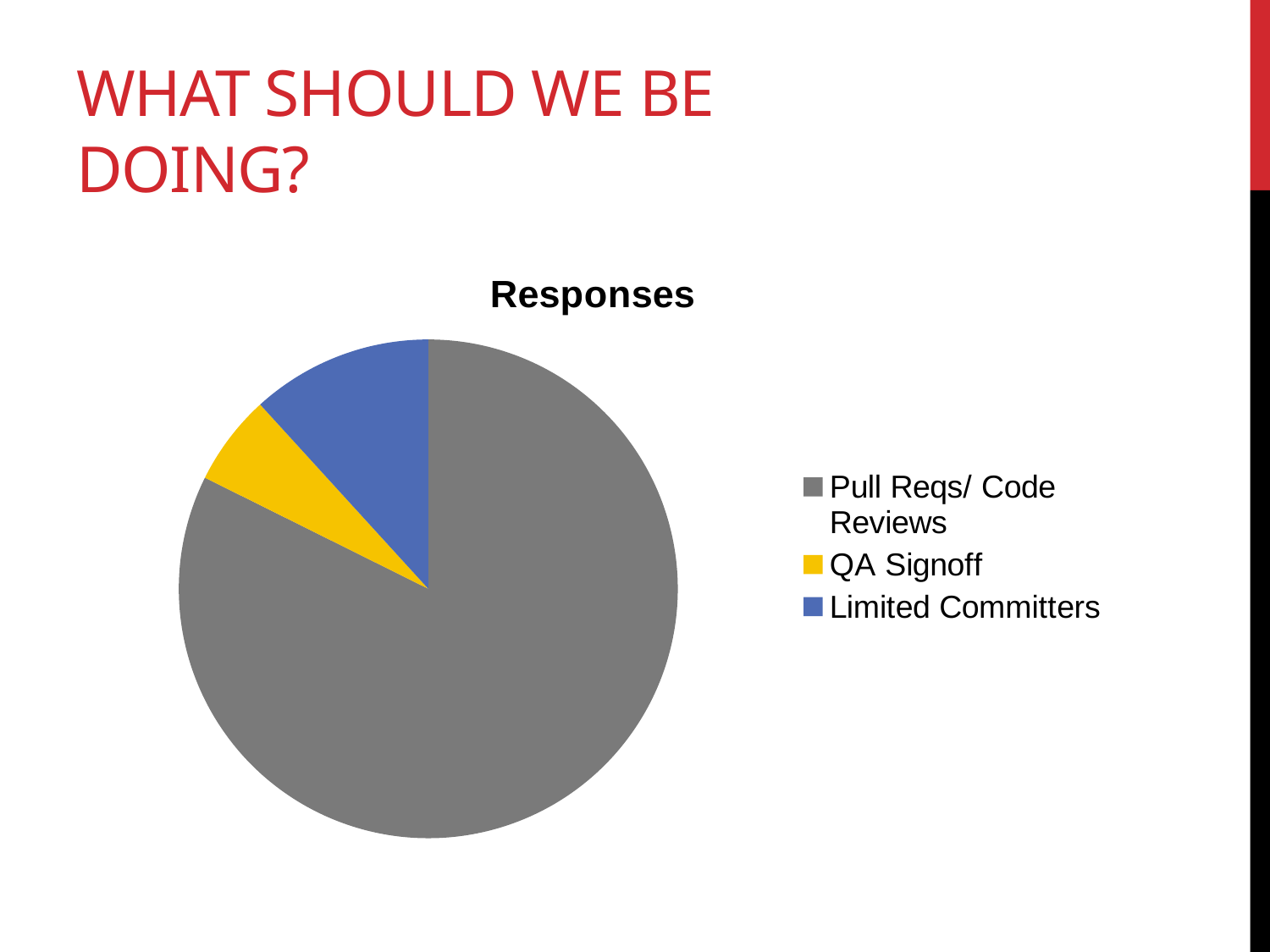
What kind of chart is shown on the slide? pie chart What colour is the slice for QA Signoff? yellow Which slice is larger, Pull Reqs/ Code Reviews or Limited Committers? Pull Reqs/ Code Reviews What is the title of the chart? Responses Which slice is larger, QA Signoff or Limited Committers? Limited Committers Which category has the largest slice of the pie? Pull Reqs/ Code Reviews How many entries does the legend list? 3 How many categories does the pie chart show? 3 Which category has the smallest slice of the pie? QA Signoff